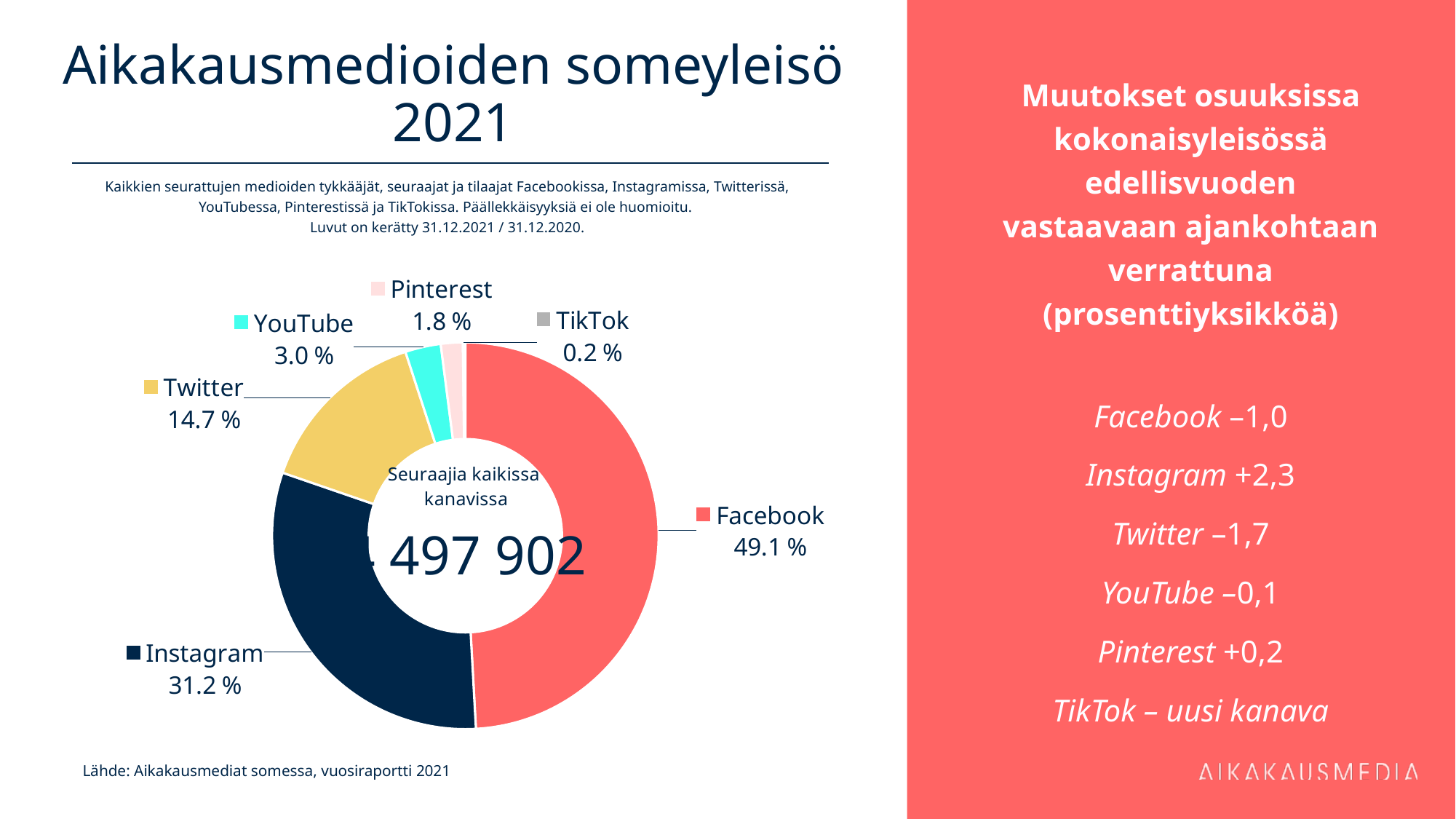
Which channel has the smallest share of the audience? TikTok What type of chart is used on the slide? Pie (donut) chart What is the value shown for Instagram? 31.2 % What percentage is shown for Twitter? 14.7 % How many channels are shown in the chart? 6 Which has a larger share, Twitter or YouTube? Twitter What share of the social media audience does Facebook hold? 49.1 % What is the difference in percentage points between Facebook and Instagram? 17.9 Which channel has the largest share of the audience? Facebook What share does Pinterest have in the chart? 1.8 % What is the title of the slide? Aikakausmedioiden someyleisö 2021 What is the value shown for YouTube? 3.0 %